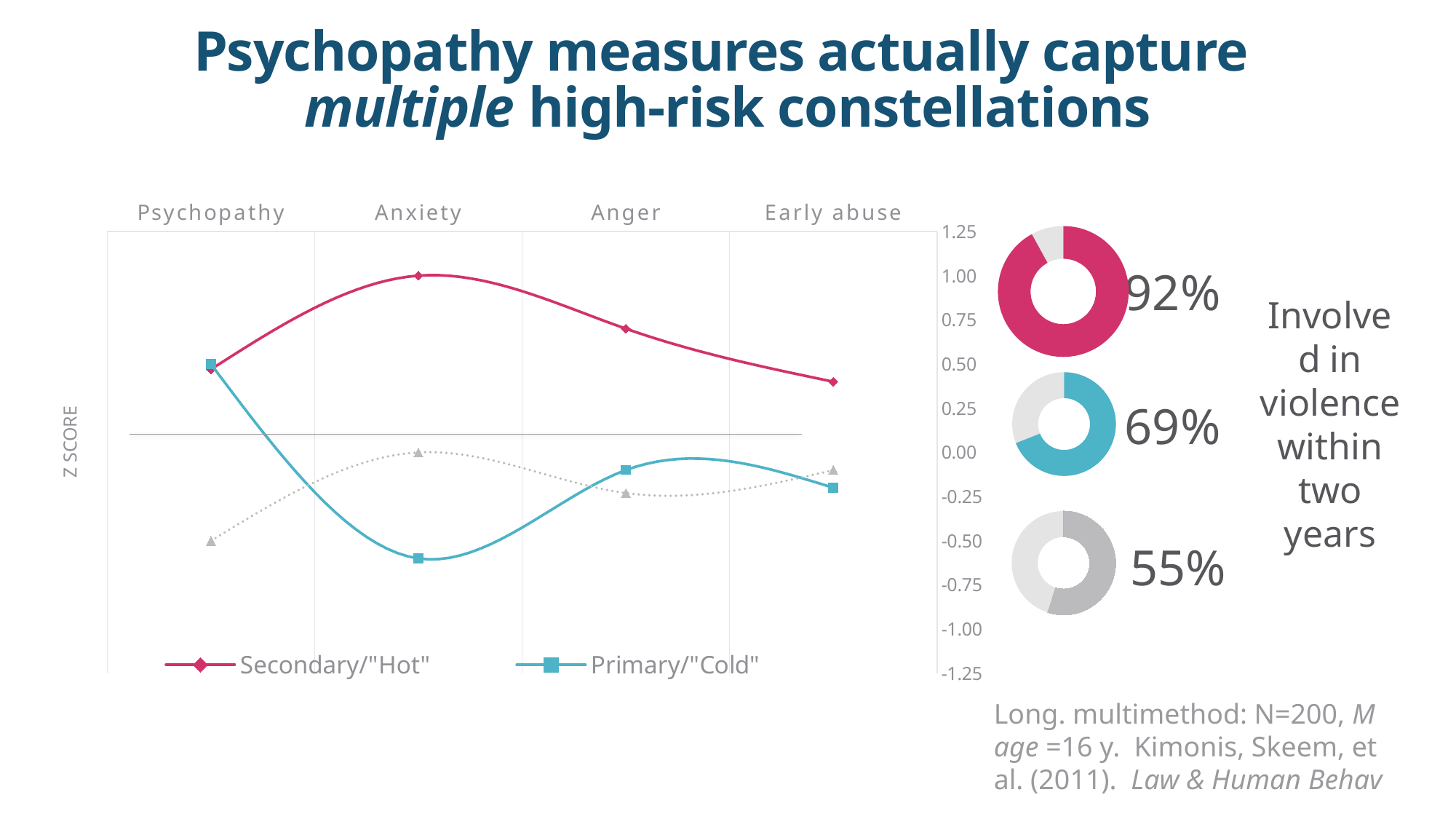
Among the three donut charts on the right, what is the difference between the top (pink) percentage and the middle (blue) percentage? 23% In the line chart, is the value for the Primary/"Cold" series at Anxiety greater or less than -0.50? less In the line chart, at which category does the Primary/"Cold" series reach its lowest value? Anxiety What kind of chart is the large chart on the left of the slide? Line chart In the line chart, at which category does the Secondary/"Hot" series reach its highest value? Anxiety In the line chart, is the value for the Secondary/"Hot" series at Anger greater or less than 0.50? greater In the line chart, does the Secondary/"Hot" series rise or fall from Anxiety to Early abuse? Fall In the line chart, how many series does the legend list? 2 In the line chart, what is the z score for the Primary/"Cold" series at Psychopathy? 0.50 In the line chart, how many categories are shown along the x axis? 4 In the line chart, what is the z score for the Secondary/"Hot" series at Anxiety? 1.00 In the line chart, which series has the larger value at Anxiety, Secondary/"Hot" or Primary/"Cold"? Secondary/"Hot"